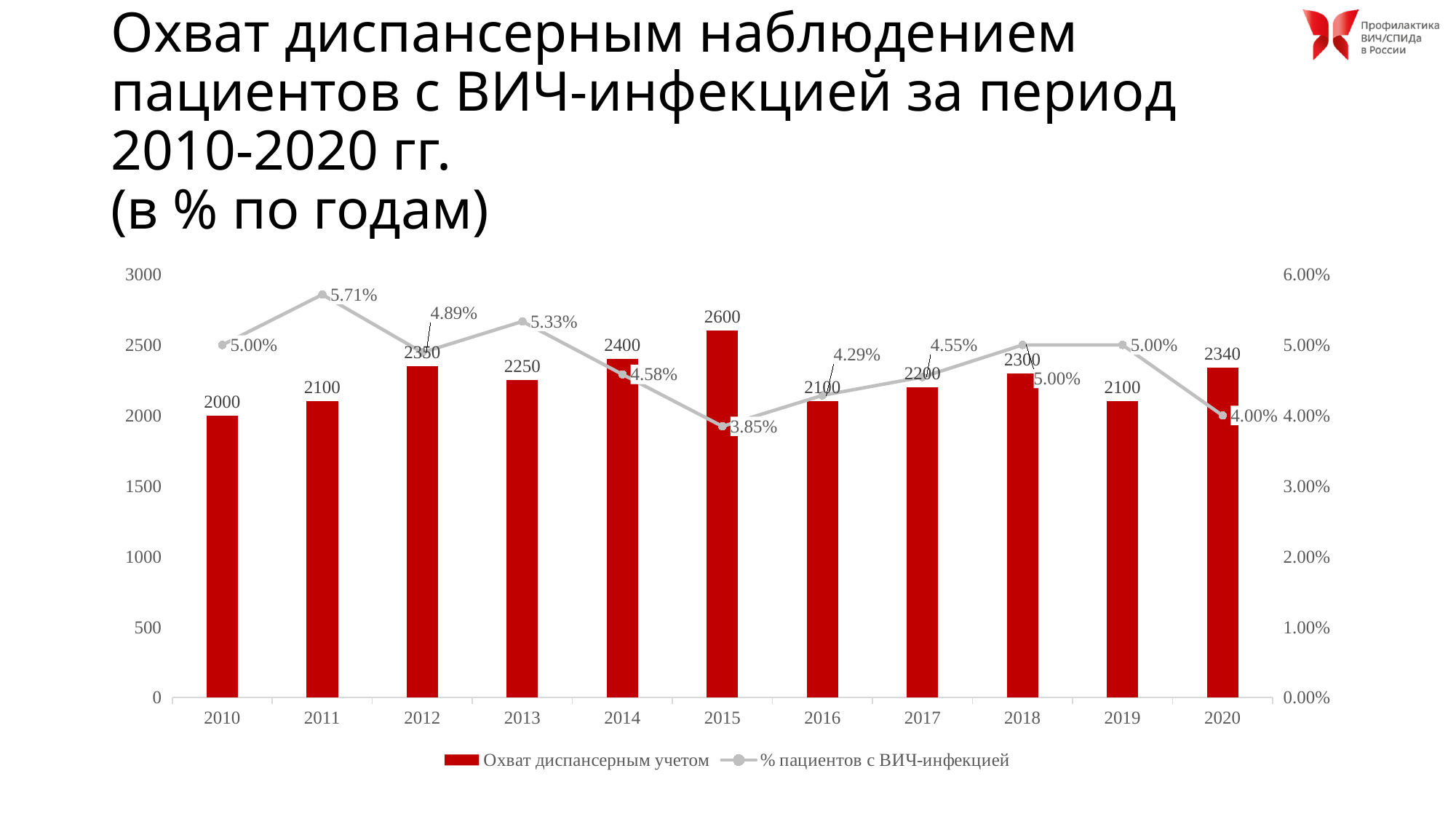
Which year has the lowest value of "% пациентов с ВИЧ-инфекцией"? 2015 What is the value of "Охват диспансерным учетом" for 2020? 2340 What is the value of "% пациентов с ВИЧ-инфекцией" for 2015? 3.85% What is the value of "Охват диспансерным учетом" for 2015? 2600 How many series does the legend list? 2 Does the "% пациентов с ВИЧ-инфекцией" line rise or fall from 2011 to 2012? Fall What is the value of "% пациентов с ВИЧ-инфекцией" for 2011? 5.71% How many years are shown on the x axis of the chart? 11 Which is larger, the "Охват диспансерным учетом" value for 2012 or for 2013? 2012 What kind of chart is shown on the slide? Combined bar and line chart Which year has the highest value of "Охват диспансерным учетом"? 2015 What is the difference between the "Охват диспансерным учетом" values for 2015 and 2010? 600